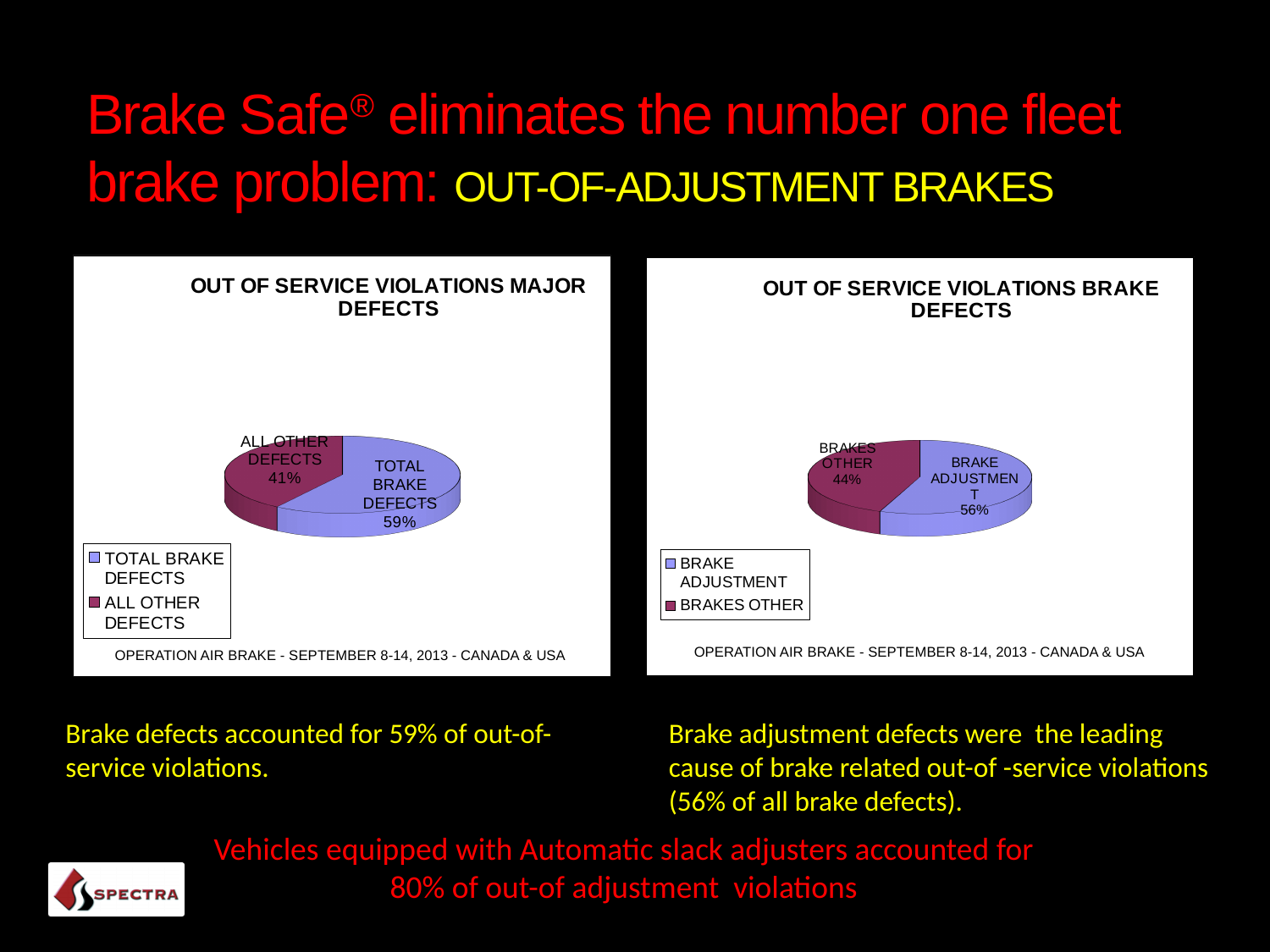
In the 'OUT OF SERVICE VIOLATIONS MAJOR DEFECTS' chart, which slice is the largest? TOTAL BRAKE DEFECTS How many entries does the legend of the 'OUT OF SERVICE VIOLATIONS MAJOR DEFECTS' chart list? 2 How many slices does the 'OUT OF SERVICE VIOLATIONS BRAKE DEFECTS' pie chart have? 2 In the 'OUT OF SERVICE VIOLATIONS BRAKE DEFECTS' chart, which slice is the smallest? BRAKES OTHER In the 'OUT OF SERVICE VIOLATIONS BRAKE DEFECTS' chart, which is larger, BRAKE ADJUSTMENT or BRAKES OTHER? BRAKE ADJUSTMENT In the 'OUT OF SERVICE VIOLATIONS BRAKE DEFECTS' chart, what share of the pie is BRAKES OTHER? 44% In the 'OUT OF SERVICE VIOLATIONS MAJOR DEFECTS' chart, what share of the pie is TOTAL BRAKE DEFECTS? 59% In the 'OUT OF SERVICE VIOLATIONS MAJOR DEFECTS' chart, what share of the pie is ALL OTHER DEFECTS? 41% What kind of chart is the 'OUT OF SERVICE VIOLATIONS MAJOR DEFECTS' chart? Pie chart In the 'OUT OF SERVICE VIOLATIONS MAJOR DEFECTS' chart, what is the difference in percentage points between TOTAL BRAKE DEFECTS and ALL OTHER DEFECTS? 18 percentage points In the 'OUT OF SERVICE VIOLATIONS BRAKE DEFECTS' chart, what is the difference in percentage points between BRAKE ADJUSTMENT and BRAKES OTHER? 12 percentage points